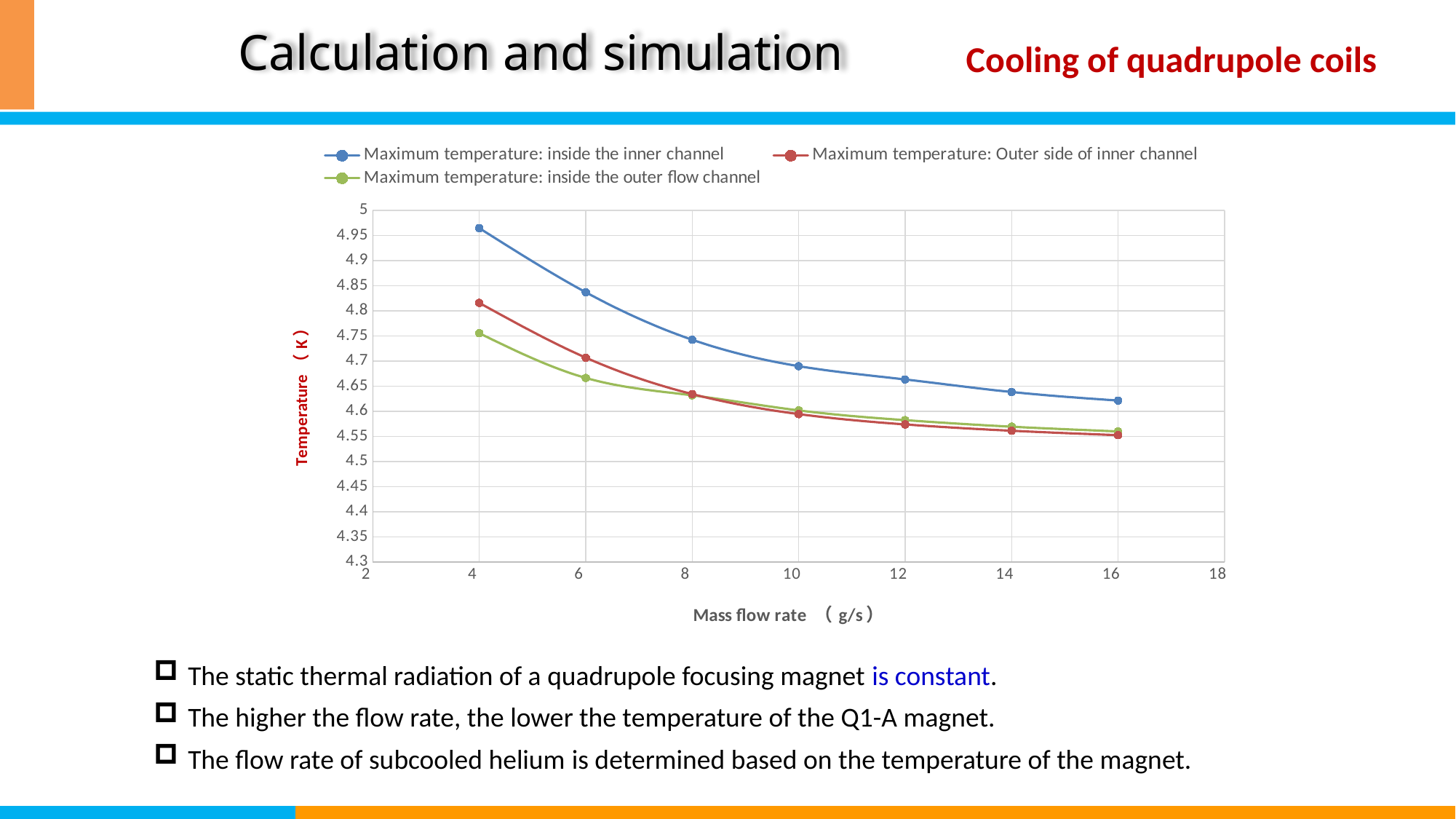
What is the title of the horizontal axis? Mass flow rate (g/s) Do the temperatures rise or fall as the mass flow rate increases? Fall Which series has the highest temperature at a mass flow rate of 4 g/s? Maximum temperature: inside the inner channel What kind of chart is shown on the slide? Line chart Which series has the lowest temperature at a mass flow rate of 4 g/s? Maximum temperature: inside the outer flow channel How many series does the legend list? 3 Is the value for 'Maximum temperature: Outer side of inner channel' at 16 g/s greater or less than 4.6? less Is the value for 'Maximum temperature: inside the inner channel' at 4 g/s greater or less than 4.9? greater Is the value for 'Maximum temperature: inside the outer flow channel' at 6 g/s greater or less than 4.7? less What is the title of the vertical axis? Temperature (K) How many data points are plotted for the series 'Maximum temperature: inside the inner channel'? 7 At a mass flow rate of 6 g/s, which is larger: 'Maximum temperature: Outer side of inner channel' or 'Maximum temperature: inside the outer flow channel'? Maximum temperature: Outer side of inner channel